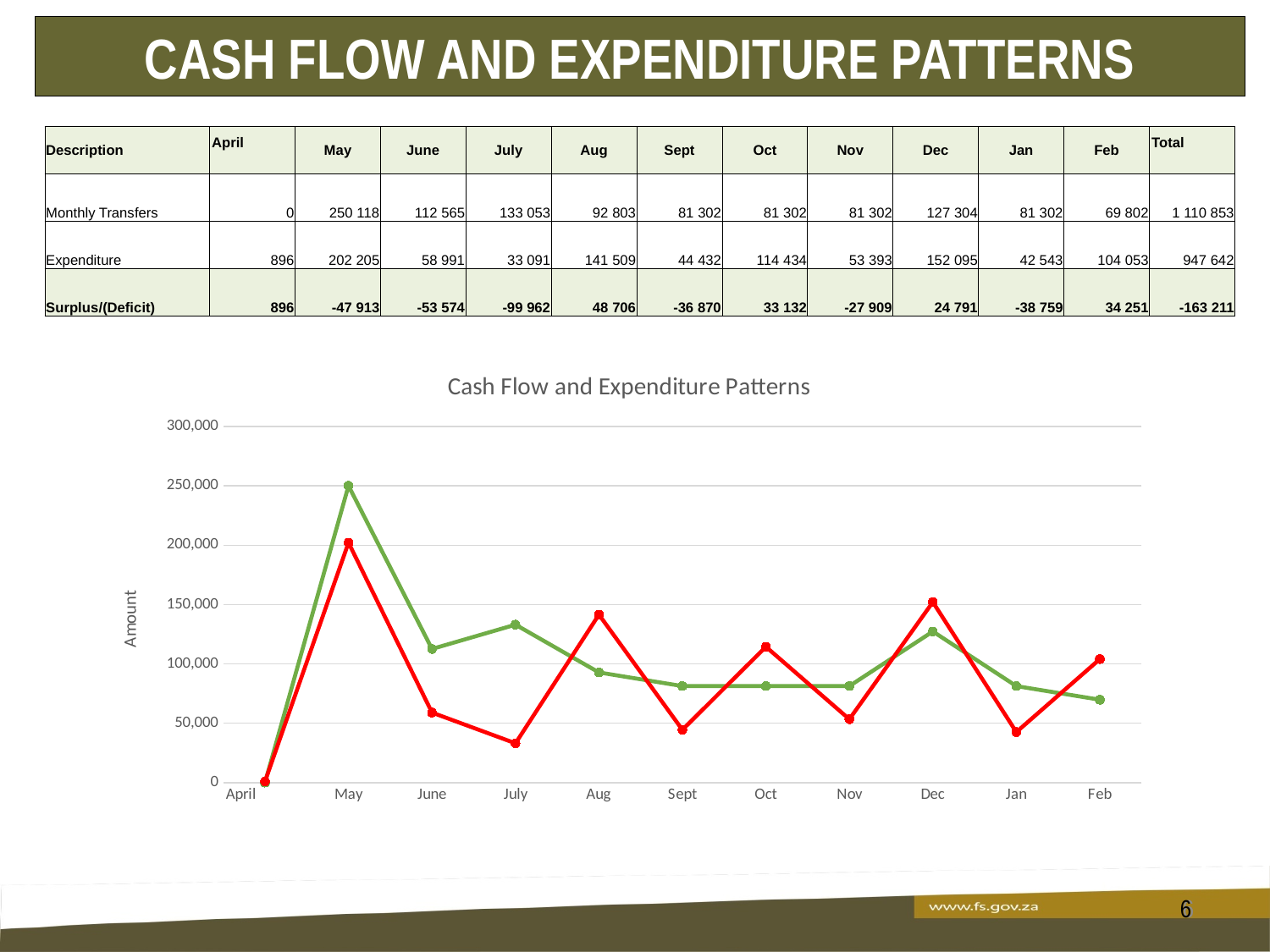
What is the label on the y axis of the chart? Amount Is the value of the green line in May greater or less than 200,000? greater In Aug, which line is higher, the red line or the green line? the red line How many lines are plotted on the chart? 2 From May to July, does the red line rise or fall? fall What kind of chart is shown on the slide? line chart According to the table, what is the Monthly Transfers value for May? 250 118 Is the value of the red line in July greater or less than 50,000? less In which month is the green line at its lowest point? April In which month does the green line reach its highest point? May What is the title of the chart? Cash Flow and Expenditure Patterns How many months are shown along the x axis of the chart? 11